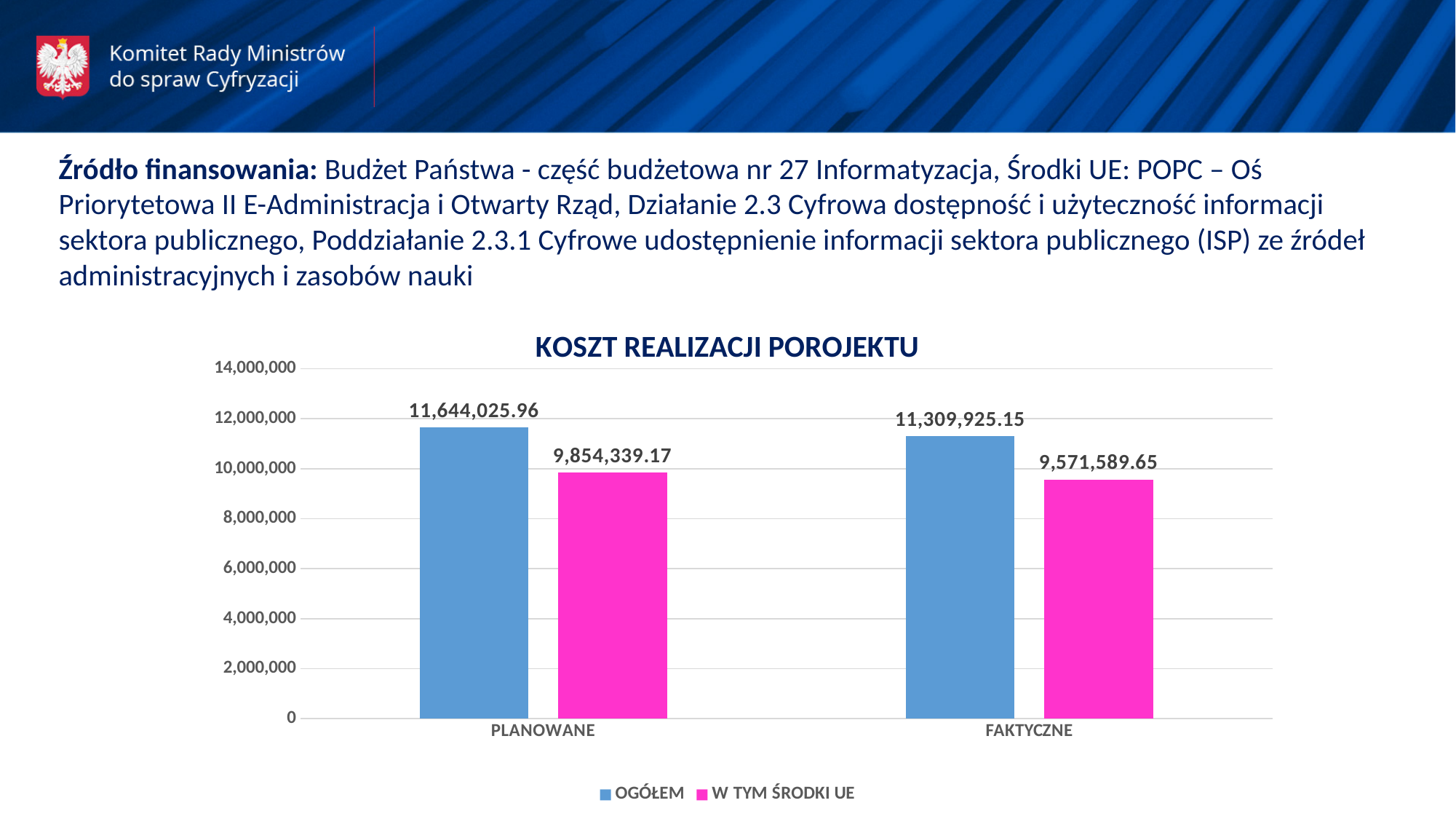
What is the OGÓŁEM value for PLANOWANE? 11,644,025.96 Is the W TYM ŚRODKI UE value for PLANOWANE larger or smaller than the W TYM ŚRODKI UE value for FAKTYCZNE? larger What is the difference between the OGÓŁEM and W TYM ŚRODKI UE values for FAKTYCZNE? 1,738,335.50 What type of chart is shown on the slide? bar chart Which bar has the highest value in the chart? PLANOWANE, OGÓŁEM What is the W TYM ŚRODKI UE value for PLANOWANE? 9,854,339.17 What is the W TYM ŚRODKI UE value for FAKTYCZNE? 9,571,589.65 What is the difference between the OGÓŁEM values for PLANOWANE and FAKTYCZNE? 334,100.81 How many series does the legend list? 2 How many categories are shown on the x axis? 2 What is the OGÓŁEM value for FAKTYCZNE? 11,309,925.15 Which bar has the lowest value in the chart? FAKTYCZNE, W TYM ŚRODKI UE